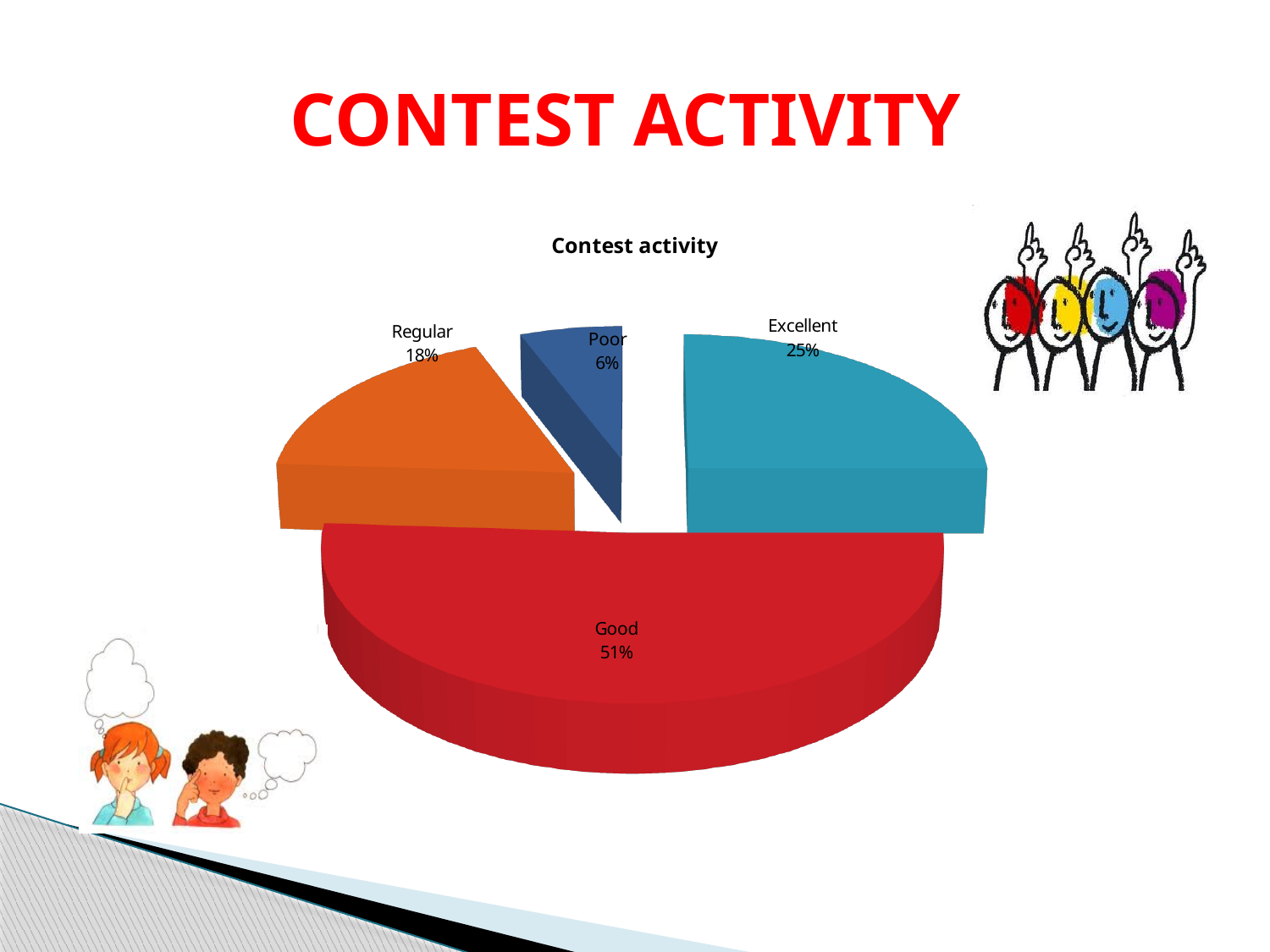
What share of the pie does Good represent? 51% Which category has the smallest slice of the pie? Poor What is the difference in percentage points between Regular and Poor? 12 What kind of chart is shown on the slide? Pie chart What is the difference in percentage points between Good and Excellent? 26 What share of the pie does Excellent represent? 25% How many categories are shown in the pie chart? 4 Which is larger, the share for Excellent or the share for Regular? Excellent Which category has the largest slice of the pie? Good What share of the pie does Poor represent? 6% What share of the pie does Regular represent? 18% What is the title of the chart? Contest activity